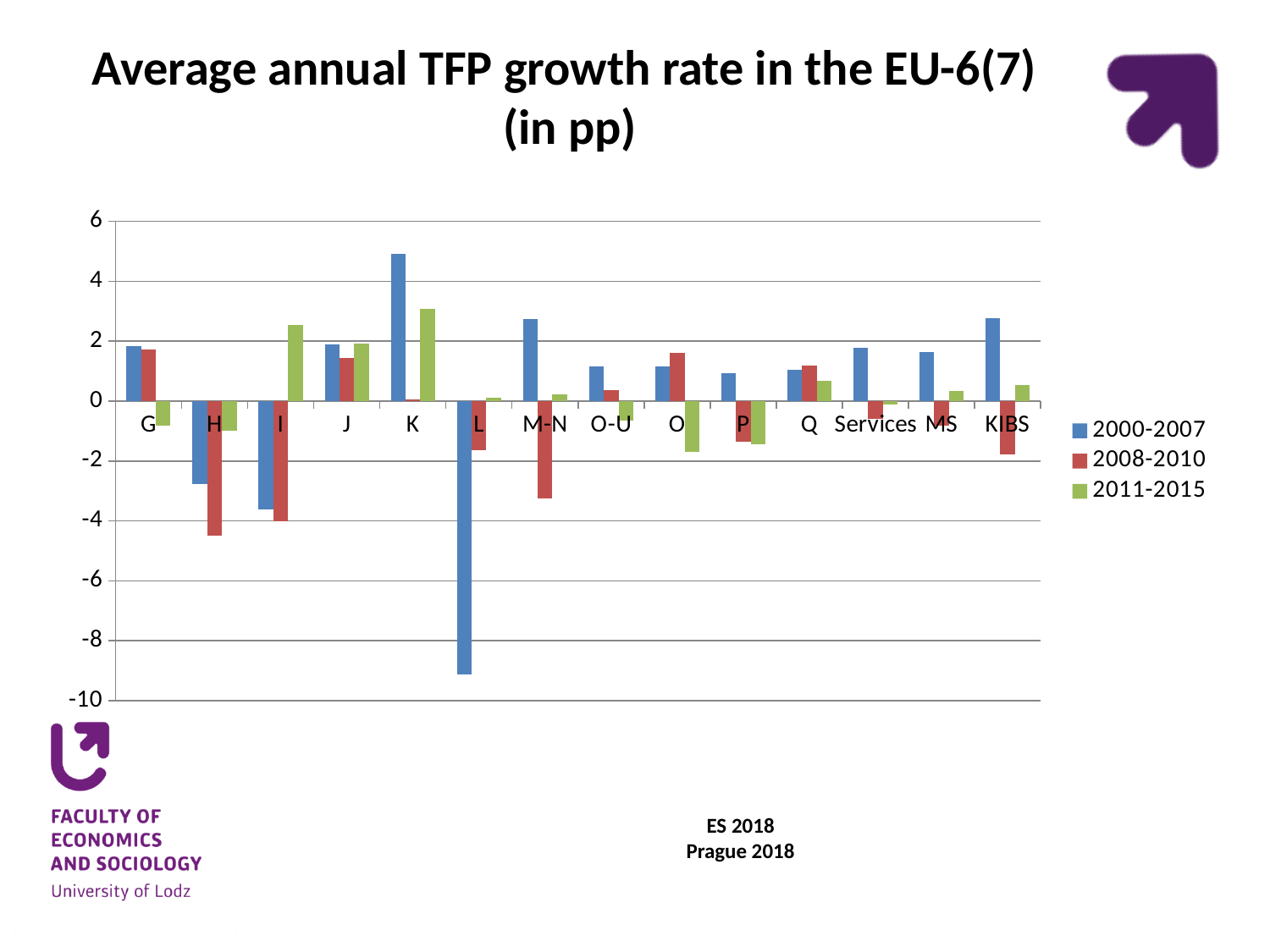
Is the 2000-2007 value for K greater or less than 4? greater What kind of chart is shown on the slide? bar chart Is the 2011-2015 value for I greater or less than 2? greater Which category has the lowest value for the 2000-2007 series? L For category O, which series has the larger value: 2000-2007 or 2008-2010? 2008-2010 How many series does the legend list? 3 How many categories are shown on the x axis? 14 Which category has the lowest value for the 2008-2010 series? H Which category has the highest value for the 2000-2007 series? K Which category has the highest value for the 2011-2015 series? K What is the title of the chart? Average annual TFP growth rate in the EU-6(7) (in pp) Is the 2000-2007 value for L greater or less than -8? less